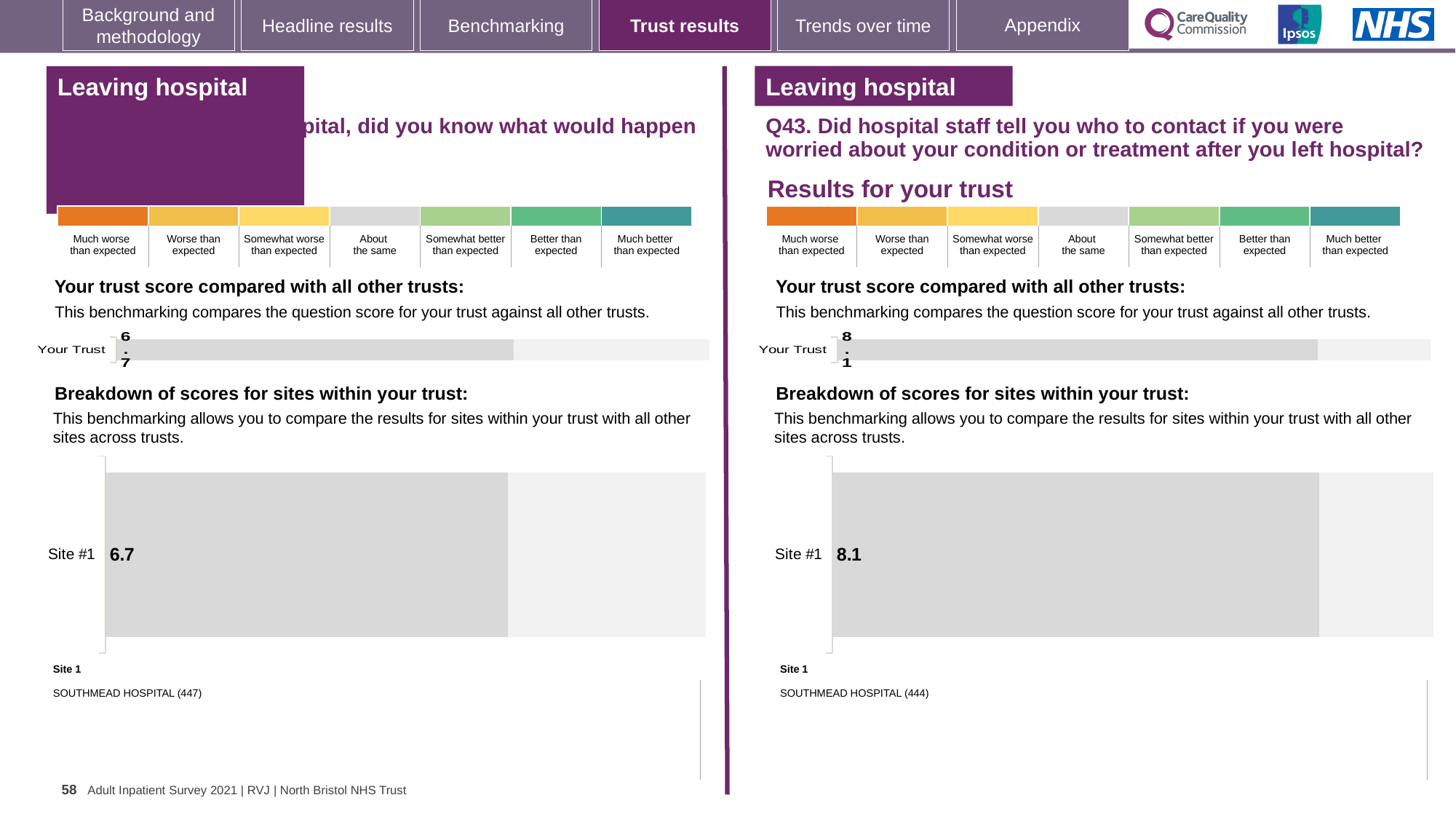
In the 'Breakdown of scores for sites within your trust' chart on the left-hand side, what is the score for Site #1? 6.7 On the left-hand side of the slide, what is the score shown for Your Trust in the 'Your trust score compared with all other trusts' chart? 6.7 How many sites are shown in the 'Breakdown of scores for sites within your trust' chart on the left-hand side? 1 What type of chart is used for the 'Your trust score compared with all other trusts' section on the right-hand side (Q43)? Bar chart Which hospital is listed as Site 1 beneath the left-hand breakdown chart? SOUTHMEAD HOSPITAL (447) How many sites are shown in the 'Breakdown of scores for sites within your trust' chart on the right-hand side (Q43)? 1 What is the difference between the Site #1 score in the right-hand (Q43) breakdown chart and the Site #1 score in the left-hand breakdown chart? 1.4 Which is larger: the Site #1 score in the left-hand breakdown chart or the Site #1 score in the right-hand (Q43) breakdown chart? The right-hand (Q43) chart Which hospital is listed as Site 1 beneath the right-hand (Q43) breakdown chart? SOUTHMEAD HOSPITAL (444) What type of chart is used for the 'Breakdown of scores for sites within your trust' section on the left-hand side? Bar chart On the right-hand side of the slide (Q43), what is the score shown for Your Trust in the 'Your trust score compared with all other trusts' chart? 8.1 In the 'Breakdown of scores for sites within your trust' chart on the right-hand side (Q43), what is the score for Site #1? 8.1